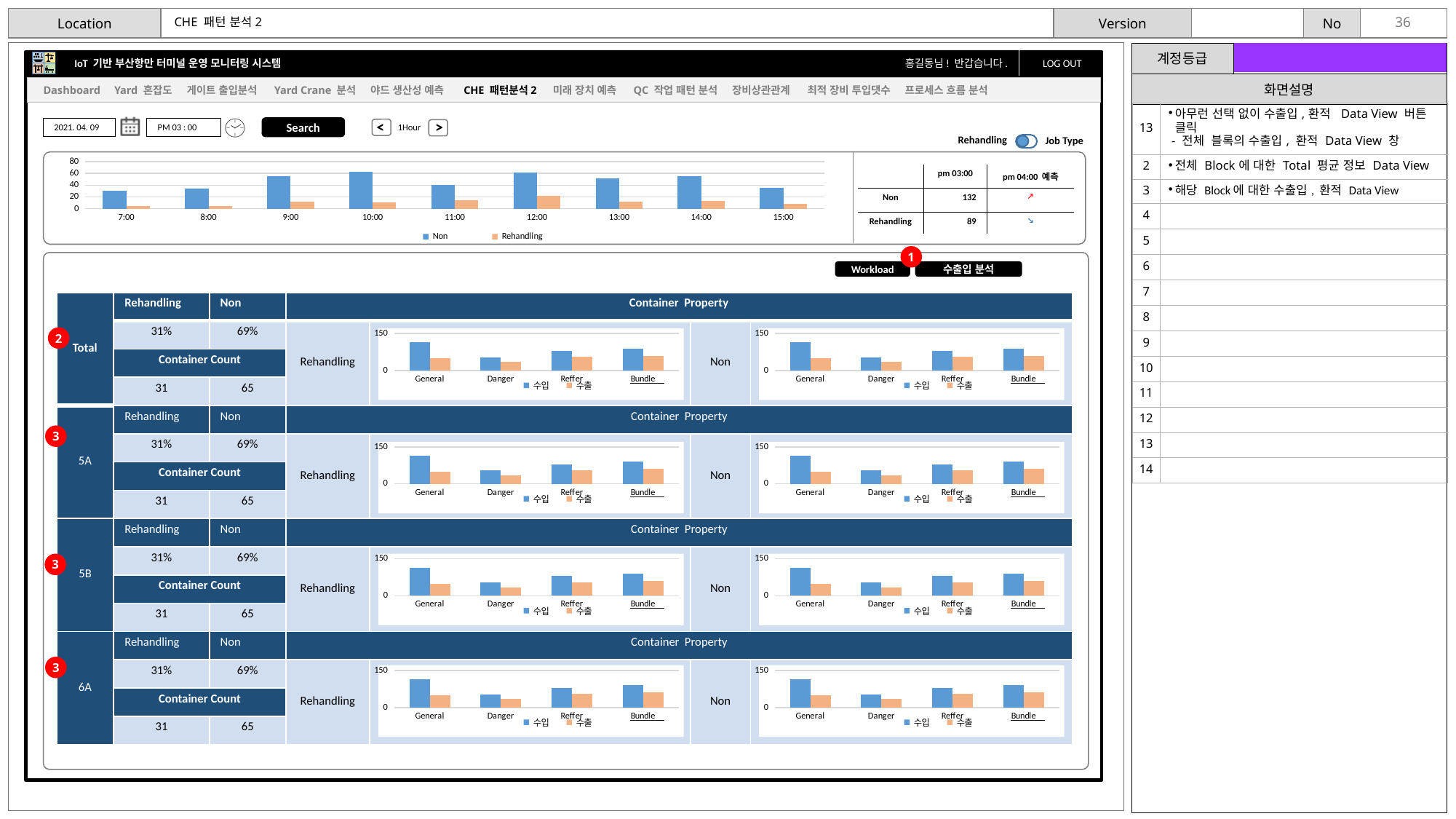
How many series does the legend of the hourly chart at the top of the slide list? 2 In the Total row's Rehandling Container Property chart, which category has the tallest bar? General In the hourly chart at the top of the slide, which is larger, the Non value at 9:00 or the Non value at 11:00? 9:00 What are the two legend entries in the Total row's Non Container Property chart? 수입, 수출 In the Total row's Rehandling Container Property chart, how many categories are shown on the x axis? 4 In the hourly chart at the top of the slide, is the Non value at 7:00 greater or less than 40? less In the hourly chart at the top of the slide, which series has the larger bar at 12:00, Non or Rehandling? Non In the hourly chart at the top of the slide, at which time is the Rehandling bar highest? 12:00 What kind of chart is the hourly chart at the top of the slide? bar chart In the hourly chart at the top of the slide, is the Rehandling value at 12:00 greater or less than 40? less How many time categories does the hourly chart at the top of the slide show on its x axis? 9 In the hourly chart at the top of the slide, is the Non value at 10:00 greater or less than 40? greater